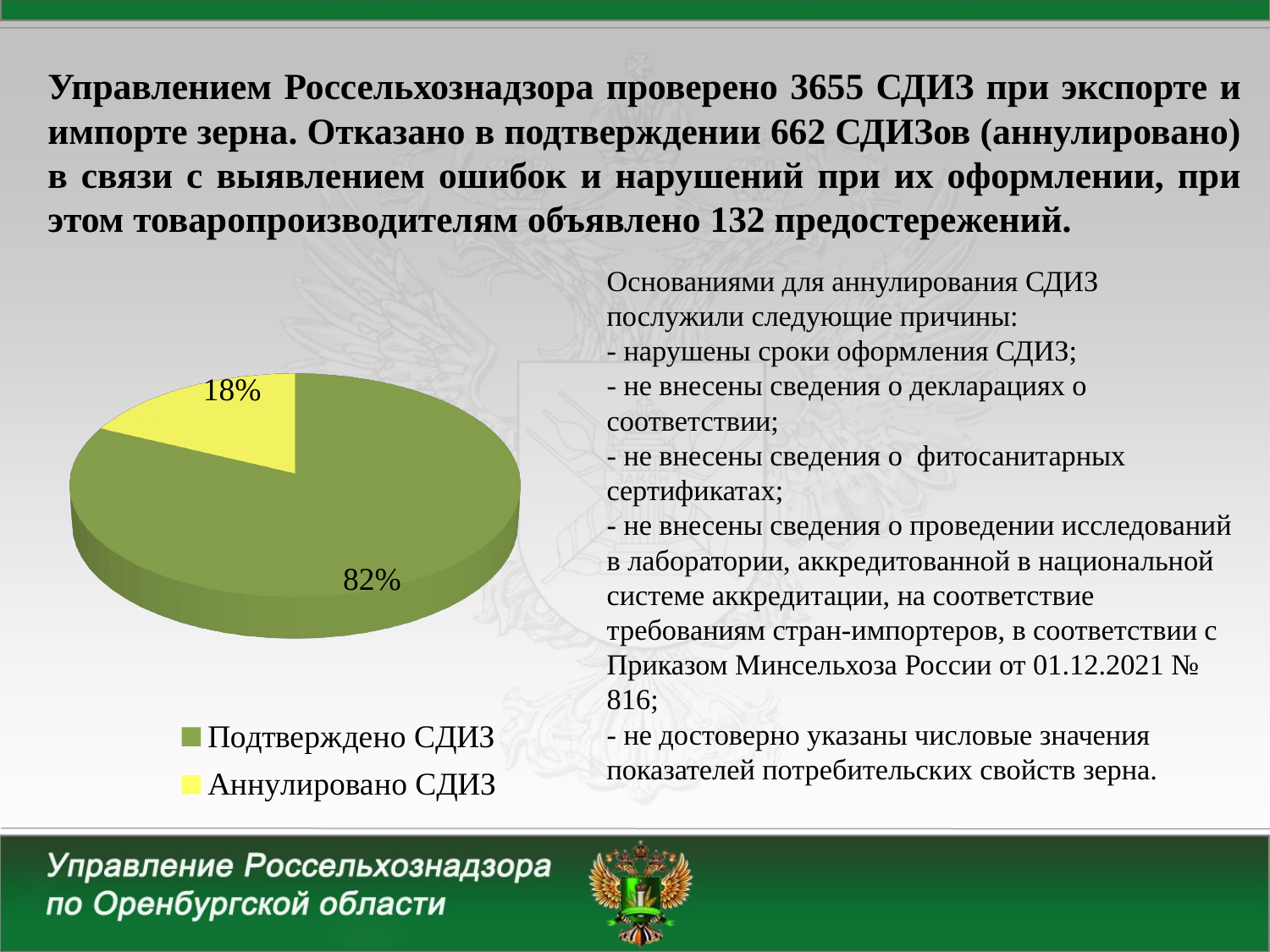
Which slice of the pie is the largest? Подтверждено СДИЗ What kind of chart is shown on the slide? pie chart How many entries does the legend list? 2 What share of the pie does "Аннулировано СДИЗ" represent? 18% Which slice of the pie is the smallest? Аннулировано СДИЗ What share of the pie does "Подтверждено СДИЗ" represent? 82% What colour is the "Подтверждено СДИЗ" slice in the pie chart? green Which is larger: the share for "Подтверждено СДИЗ" or for "Аннулировано СДИЗ"? Подтверждено СДИЗ What is the difference in percentage points between the "Подтверждено СДИЗ" and "Аннулировано СДИЗ" slices? 64 How many slices does the pie chart have? 2 What colour is the "Аннулировано СДИЗ" slice in the pie chart? yellow